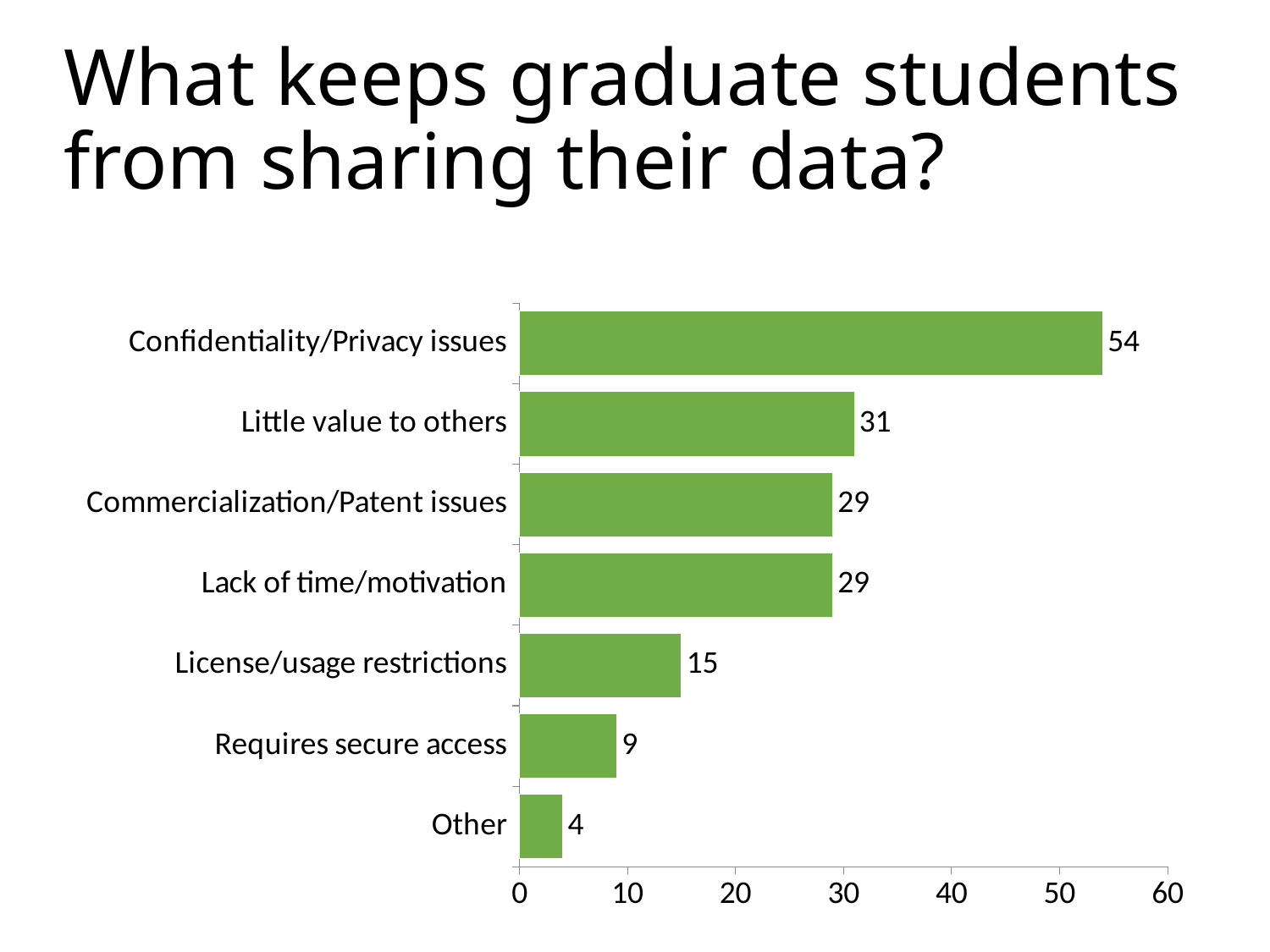
How many categories are shown in the chart? 7 Which category has the lowest value? Other What is the value for Requires secure access? 9 What is the difference between the values for Confidentiality/Privacy issues and Little value to others? 23 What is the title of the slide? What keeps graduate students from sharing their data? Which category has the highest value? Confidentiality/Privacy issues What is the value for Little value to others? 31 Which is larger, the value for License/usage restrictions or the value for Requires secure access? License/usage restrictions What is the value for License/usage restrictions? 15 What is the value for Confidentiality/Privacy issues? 54 What kind of chart is shown on the slide? Bar chart Is the value for Lack of time/motivation greater or less than 20? greater